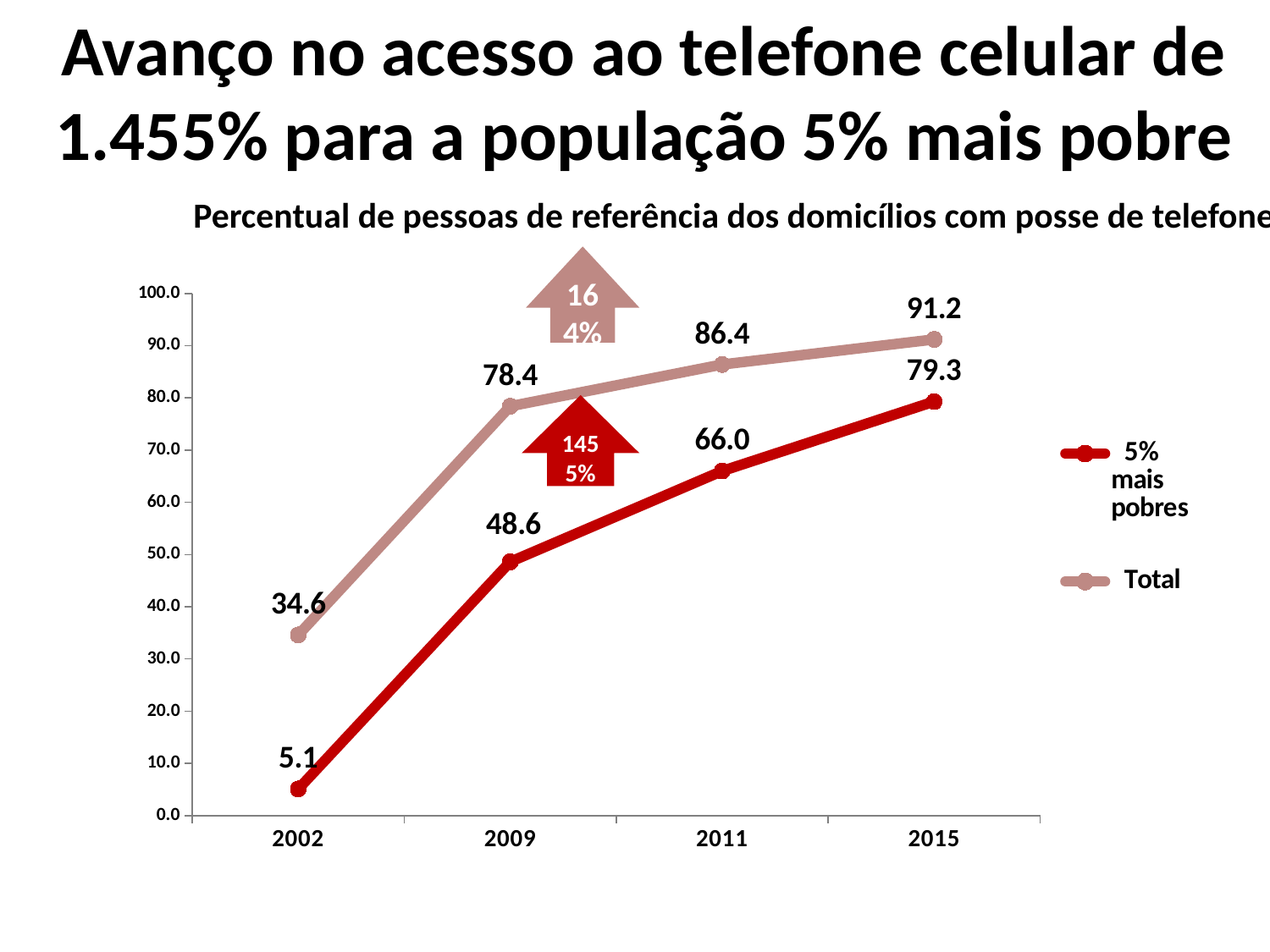
What is the value for the 'Total' series in 2011? 86.4 Which is larger in 2009: the 'Total' value or the '5% mais pobres' value? Total Do the values for the '5% mais pobres' series rise or fall from 2002 to 2015? Rise How many years are shown on the x axis? 4 What is the difference between the 'Total' and '5% mais pobres' values in 2015? 11.9 In which year is the '5% mais pobres' series lowest? 2002 How many series does the legend list? 2 In which year is the 'Total' series highest? 2015 What is the value for the '5% mais pobres' series in 2015? 79.3 What is the value for the 'Total' series in 2009? 78.4 What kind of chart is shown on the slide? Line chart What is the value for the '5% mais pobres' series in 2002? 5.1